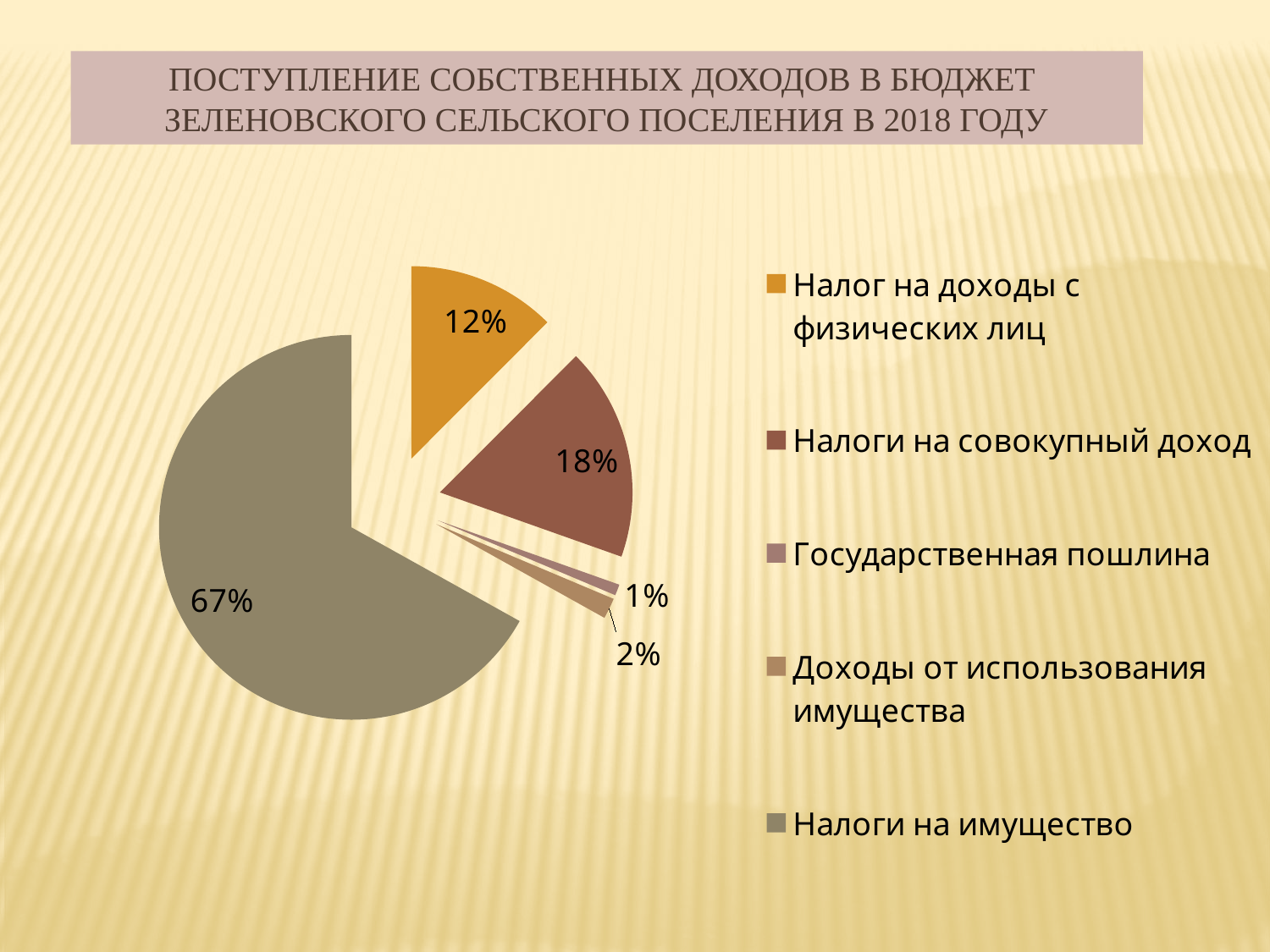
What is the difference in percentage points between "Налоги на совокупный доход" and "Налог на доходы с физических лиц"? 6% Which category has the smallest slice of the pie? Государственная пошлина What colour is the slice for "Налог на доходы с физических лиц"? orange What share of the pie does "Налоги на имущество" have? 67% What share of the pie does "Налог на доходы с физических лиц" have? 12% What kind of chart is shown on the slide? pie chart Which category has the largest slice of the pie? Налоги на имущество Which is larger: the share for "Налог на доходы с физических лиц" or the share for "Налоги на совокупный доход"? Налоги на совокупный доход What share of the pie does "Доходы от использования имущества" have? 2% How many categories does the pie chart have? 5